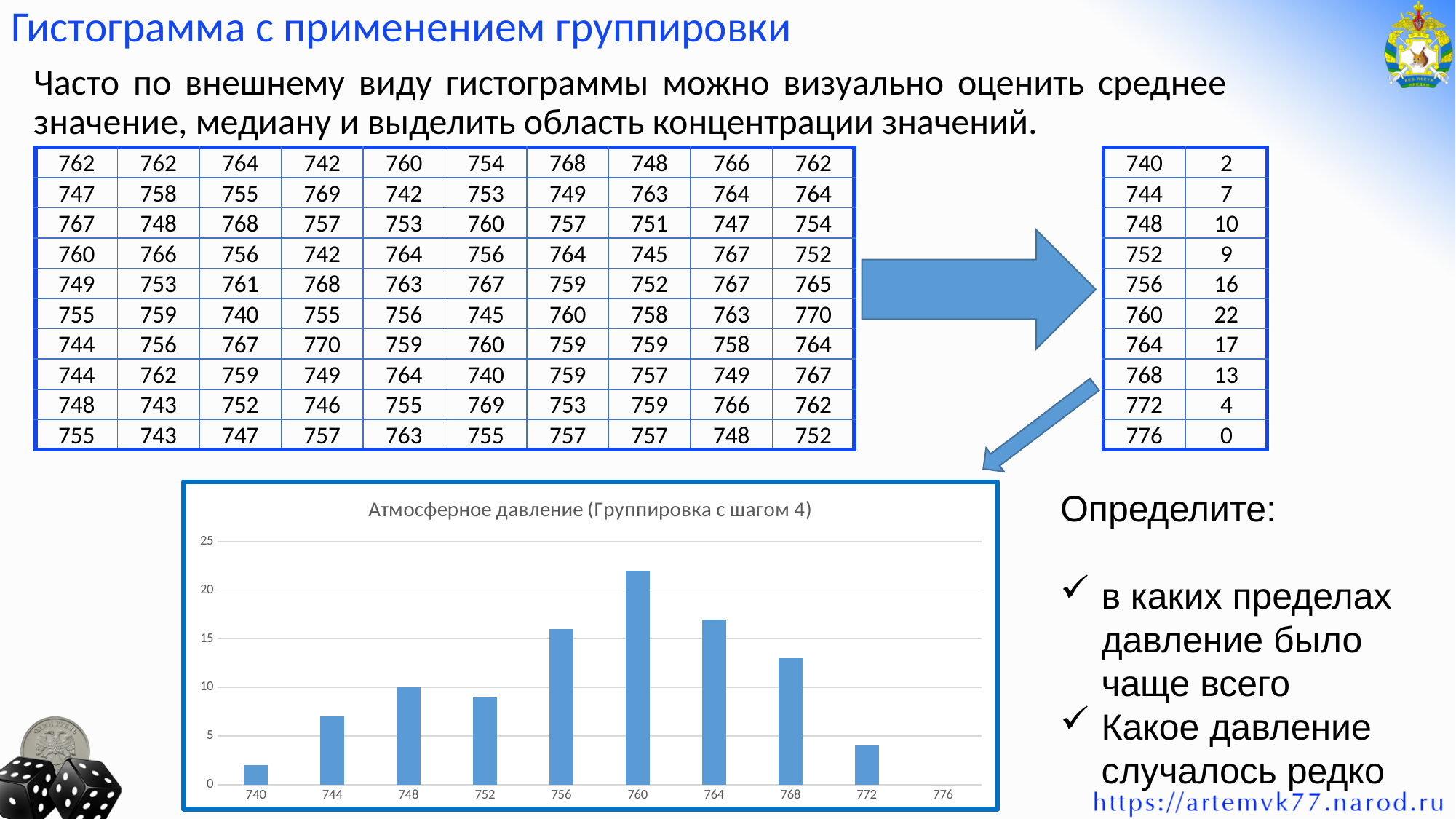
What is the value for category 760 in the chart? 22 Which category has the lowest value in the chart? 776 Is the value for 772 greater or less than 5? less Is the value for 756 greater or less than 15? greater What is the value for category 748 in the chart? 10 Which is larger, the value for 764 or the value for 768? 764 What is the value for category 776 in the chart? 0 What is the title of the chart? Атмосферное давление (Группировка с шагом 4) Which category has the highest bar in the chart? 760 Do the values rise or fall from category 740 to category 760? rise What type of chart is shown on the slide? Bar chart How many categories are shown on the x axis of the chart? 10